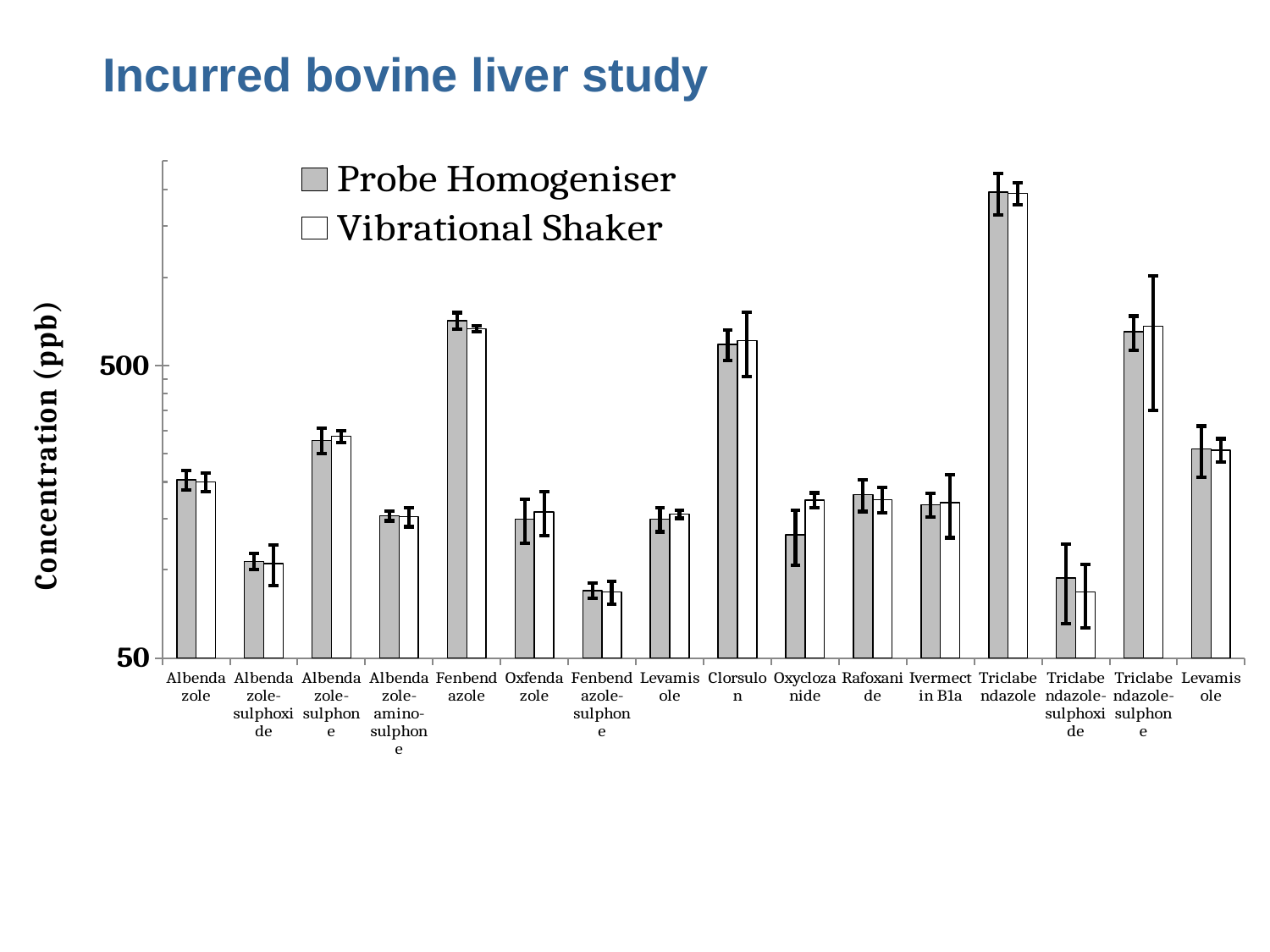
Which is larger for Vibrational Shaker: Albendazole-sulphone or Albendazole-sulphoxide? Albendazole-sulphone Which category has the lowest Probe Homogeniser value? Fenbendazole-sulphone What kind of chart is shown on the slide? bar chart Which category has the highest Probe Homogeniser value? Triclabendazole Is the Probe Homogeniser value for Triclabendazole greater or less than 500? greater Which category has the highest Vibrational Shaker value? Triclabendazole How many series does the legend list? 2 Is the Probe Homogeniser value for Fenbendazole greater or less than 500? greater Is the Vibrational Shaker value for Albendazole greater or less than 500? less How many categories are shown along the x axis? 16 Which is larger for Probe Homogeniser: Fenbendazole or Albendazole? Fenbendazole What is the label of the y axis? Concentration (ppb)